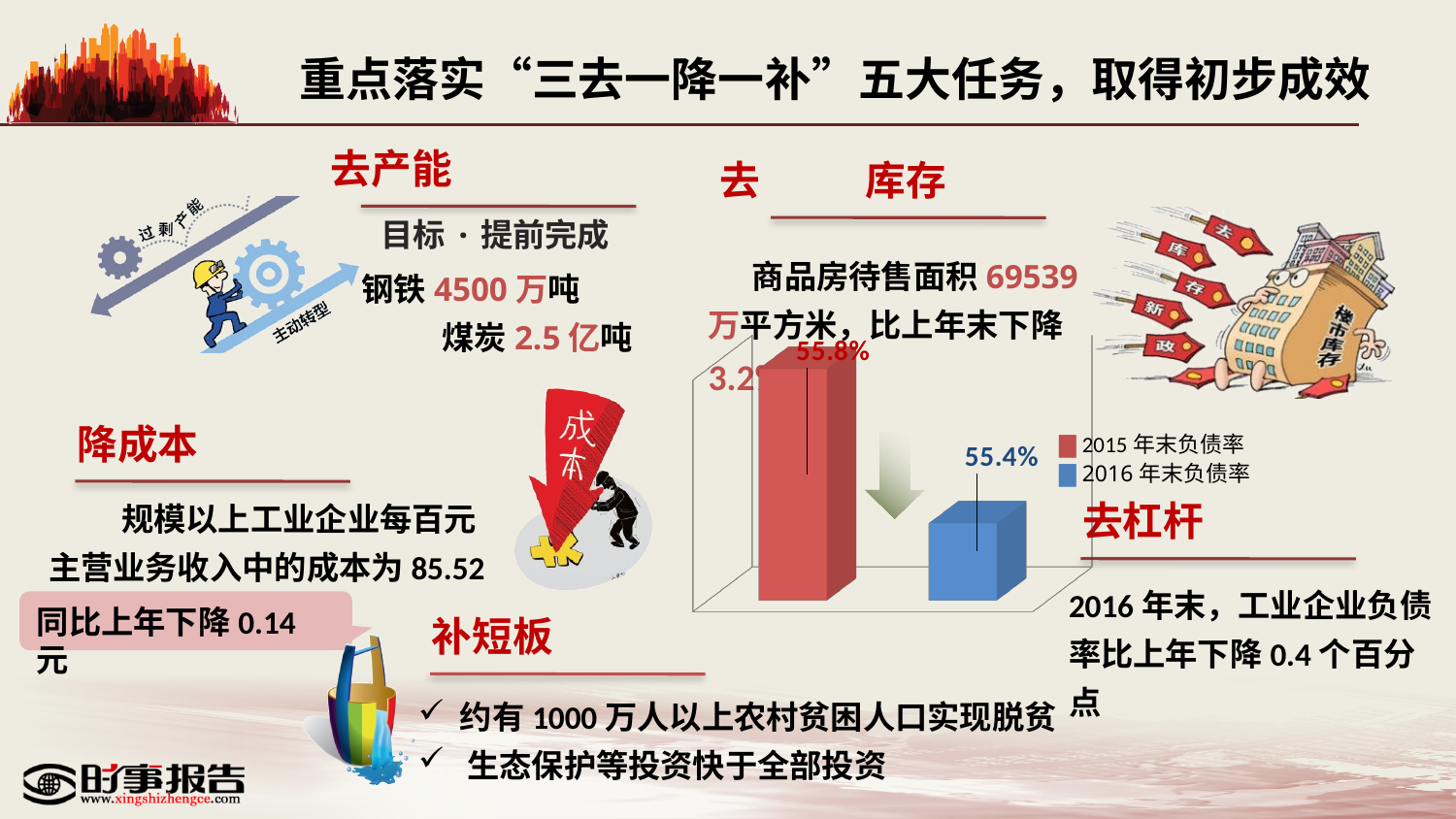
What colour is the bar for 2015 年末负债率 in the chart? red Which series has the lower value in the bar chart? 2016 年末负债率 Do the values fall or rise from 2015 年末负债率 to 2016 年末负债率 in the chart? fall What is the difference between the 2015 年末负债率 and 2016 年末负债率 values in the bar chart? 0.4% Which series has the higher value in the bar chart, 2015 年末负债率 or 2016 年末负债率? 2015 年末负债率 Is the value for 2016 年末负债率 larger or smaller than the value for 2015 年末负债率? smaller What is the value shown for 2015 年末负债率 in the bar chart? 55.8% How many series does the chart legend list? 2 What kind of chart is shown on the slide? bar chart What is the value shown for 2016 年末负债率 in the bar chart? 55.4% What colour is the bar for 2016 年末负债率 in the chart? blue How many bars are plotted in the chart? 2